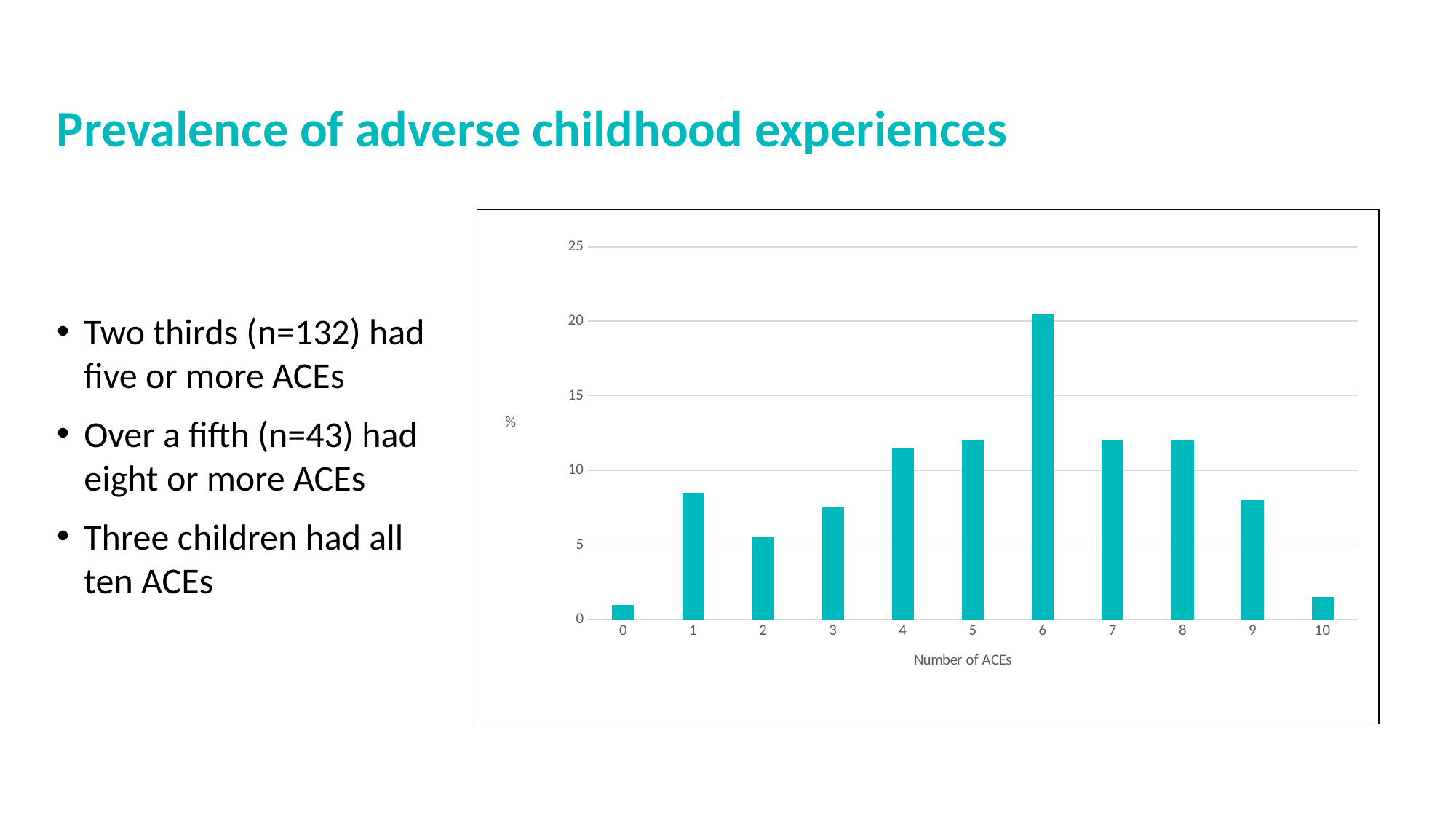
Which number of ACEs has the highest percentage? 6 Is the value for 9 ACEs greater or less than 10? less What label is shown on the y axis? % How many categories (numbers of ACEs) are plotted on the x axis? 11 Is the value for 4 ACEs greater or less than 10? greater Is the value for 10 ACEs greater or less than 5? less What is the title of the x axis? Number of ACEs Which is larger, the value for 4 ACEs or the value for 9 ACEs? 4 ACEs What kind of chart is shown on the slide? bar chart Which is larger, the value for 1 ACE or the value for 2 ACEs? 1 ACE